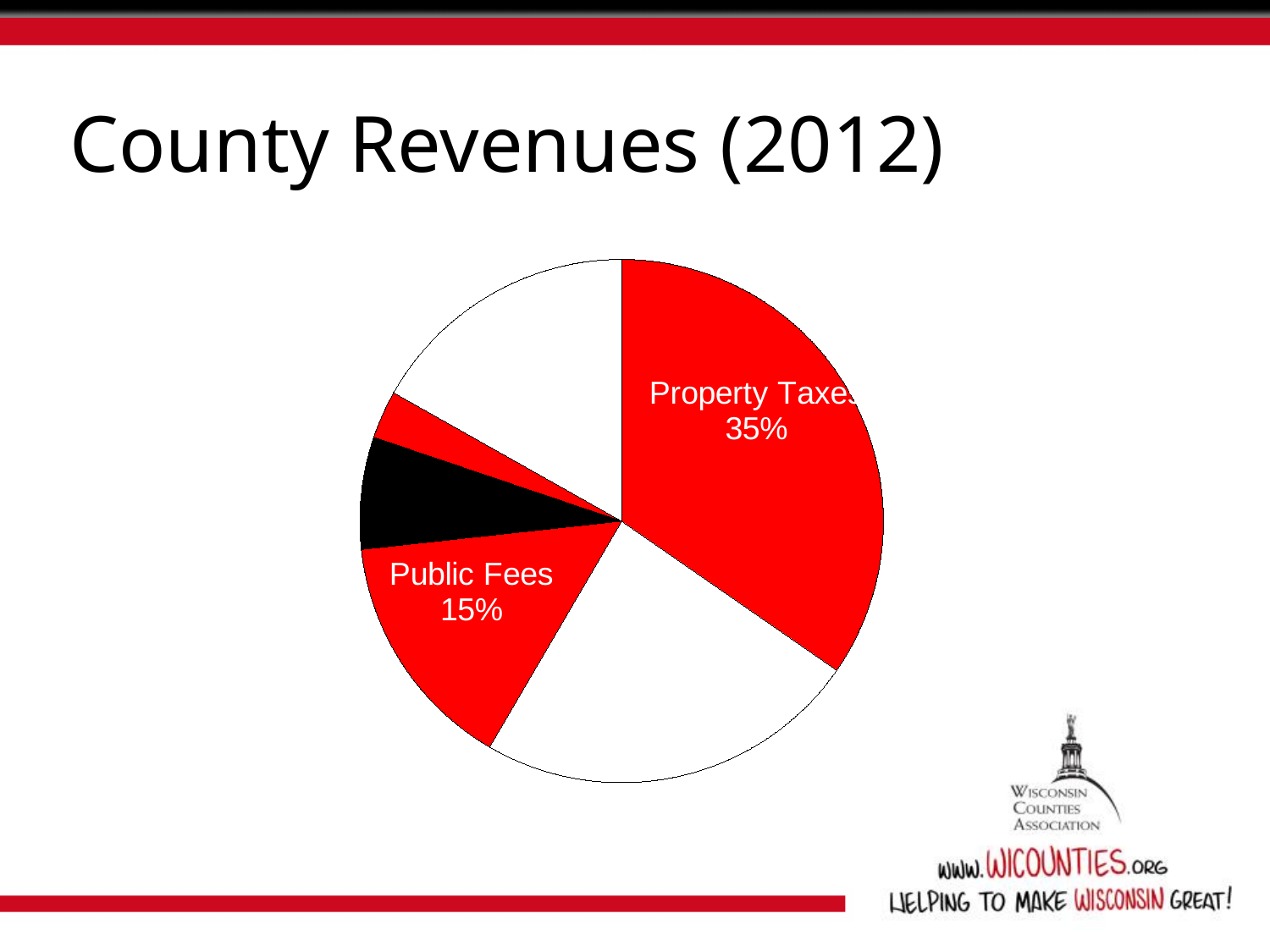
What share of county revenues comes from Property Taxes? 35% Which labeled category is the largest slice of the pie? Property Taxes What is the title of the chart on the slide? County Revenues (2012) What kind of chart is shown on the slide? pie chart Which is larger, the Property Taxes slice or the Public Fees slice? Property Taxes What colour is the Property Taxes slice? red What share of county revenues comes from Public Fees? 15% By how many percentage points does the Property Taxes share exceed the Public Fees share? 20 percentage points How many slices does the pie chart have? 6 Which labeled category is the smallest slice of the pie? Public Fees